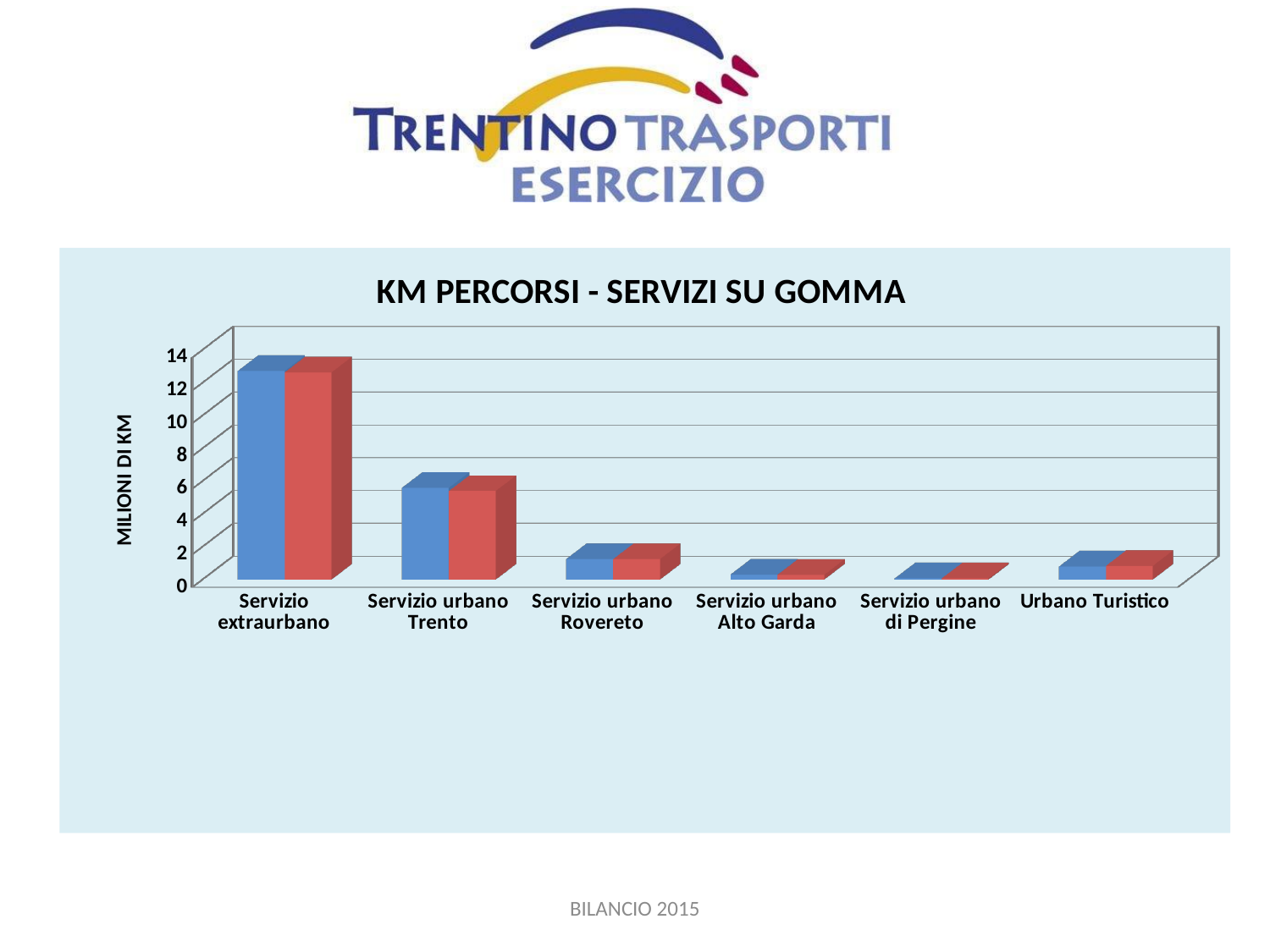
What is the label on the vertical axis of the chart? MILIONI DI KM Which is larger, the value for Servizio extraurbano or the value for Servizio urbano Trento? Servizio extraurbano How many service categories are shown on the x axis of the chart? 6 Is the value for Servizio urbano Alto Garda greater or less than 2? less Which is larger, the value for Servizio urbano Rovereto or the value for Servizio urbano di Pergine? Servizio urbano Rovereto Is the value for Servizio urbano Trento greater or less than 4? greater Is the value for Servizio urbano Rovereto greater or less than 2? less Which category has the highest value in the chart? Servizio extraurbano What kind of chart is shown on the slide? bar chart What is the title of the chart? KM PERCORSI - SERVIZI SU GOMMA